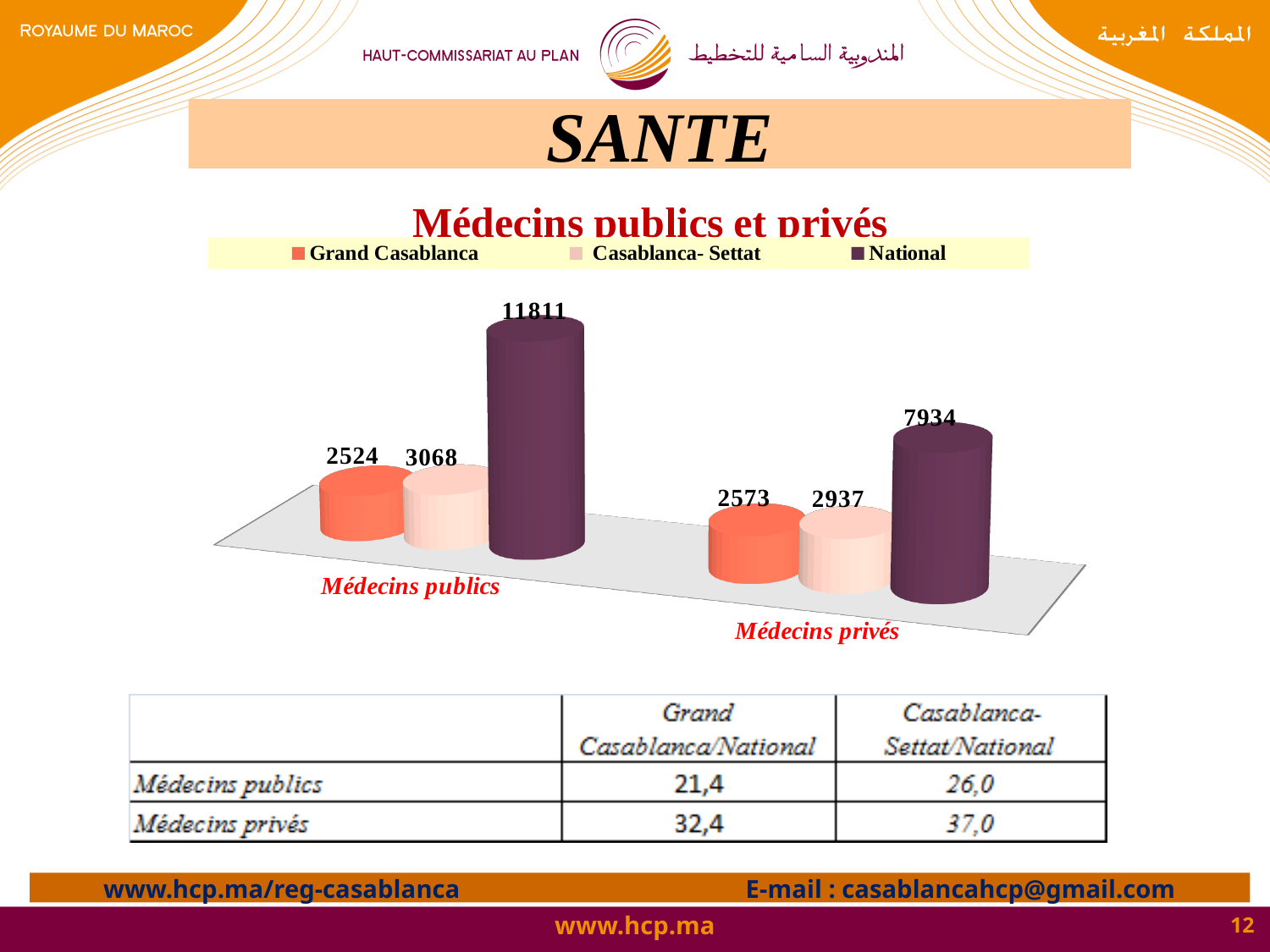
Which series has the lowest value in the Médecins privés category? Grand Casablanca What is the value for Casablanca- Settat in the Médecins publics category? 3068 What is the title of the chart? Médecins publics et privés What is the difference between the National values for Médecins publics and Médecins privés? 3877 What is the value for Grand Casablanca in the Médecins privés category? 2573 What is the difference between the Casablanca- Settat and Grand Casablanca values for Médecins publics? 544 Which series has the highest value in the Médecins publics category? National How many series does the chart legend list? 3 Which is larger: the Grand Casablanca value for Médecins publics or for Médecins privés? Médecins privés What is the value for National in the Médecins publics category? 11811 What is the value for National in the Médecins privés category? 7934 How many categories are shown on the x axis of the chart? 2